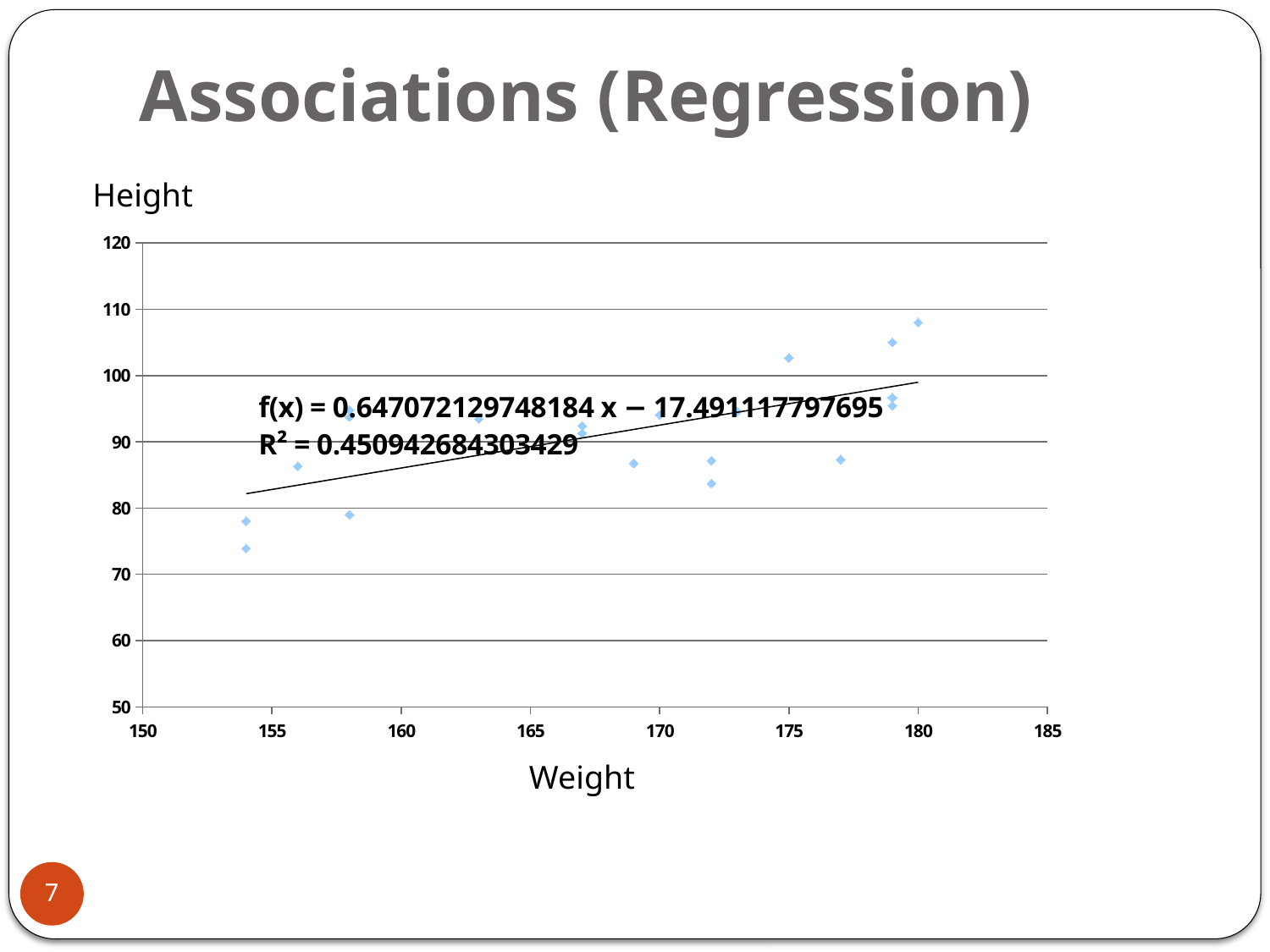
Which has the higher plotted height: the point at weight 180 or the point at weight 177? The point at weight 180 Is the height value for the point at weight 175 greater or less than 100? greater Do the plotted heights generally rise or fall as weight increases along the x axis? Rise Is the height value for the point at weight 180 greater or less than 100? greater What is the R² value printed on the chart? 0.450942684303429 At which weight value does the lowest plotted height occur? 154 At which weight value does the highest plotted height occur? 180 Is the height value for the point at weight 169 greater or less than 90? less What is the label of the x axis of the chart? Weight What kind of chart is shown on the slide? Scatter chart